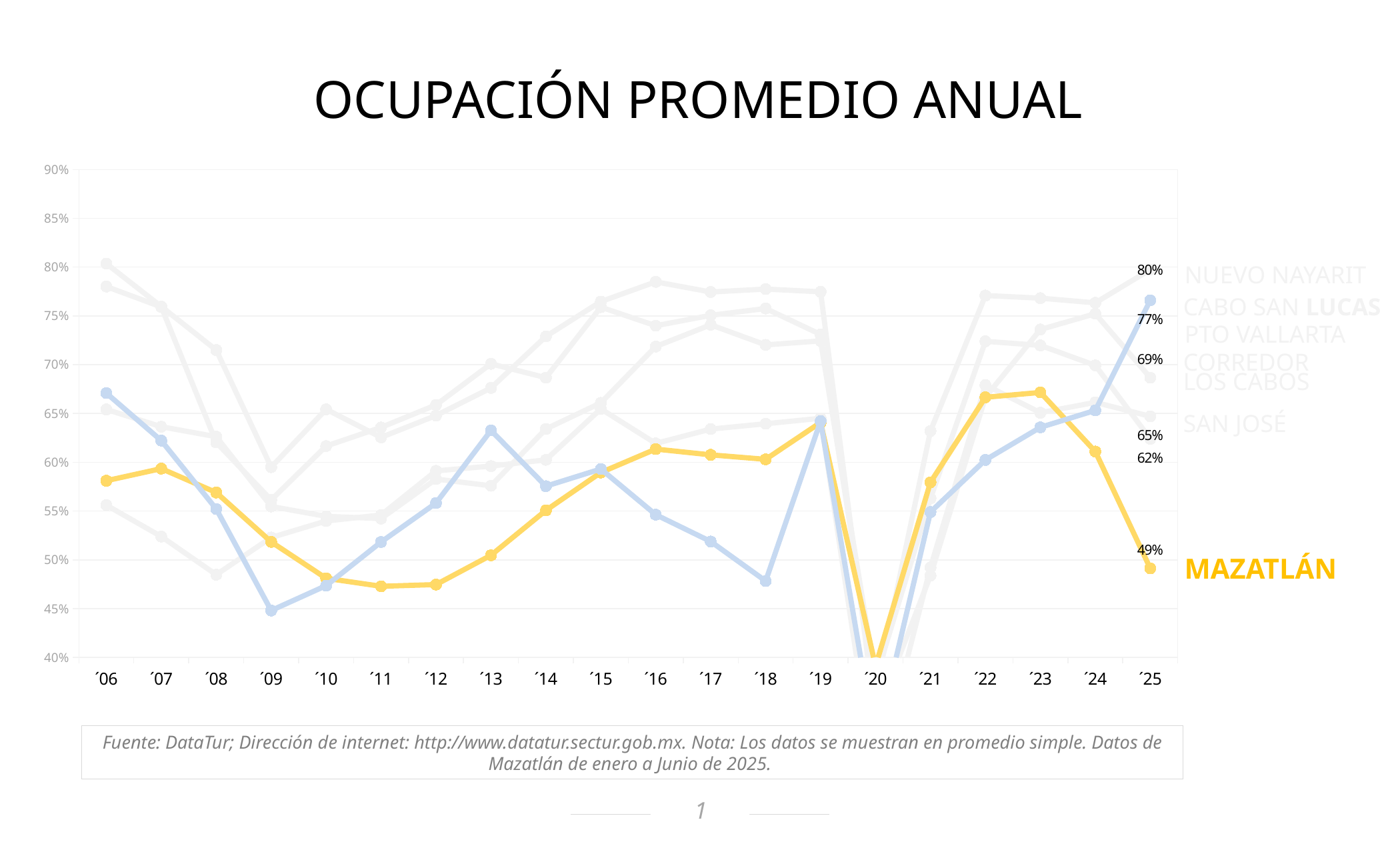
Is the value for Mazatlán in '20 greater or less than 45%? less How many years are shown along the x axis? 20 What is the value for Mazatlán in '25? 49% Is the value for Mazatlán in '23 greater or less than 65%? greater What colour is the Mazatlán line? Yellow What is the highest value labeled at '25 on the chart? 80% Does the Mazatlán line rise or fall from '22 to '25? Fall Is the value for Mazatlán in '09 greater or less than 55%? less What is the title of the chart? OCUPACIÓN PROMEDIO ANUAL Which is higher for Mazatlán, '24 or '25? '24 What kind of chart is shown on the slide? Line chart In which year is the Mazatlán line at its lowest? '20